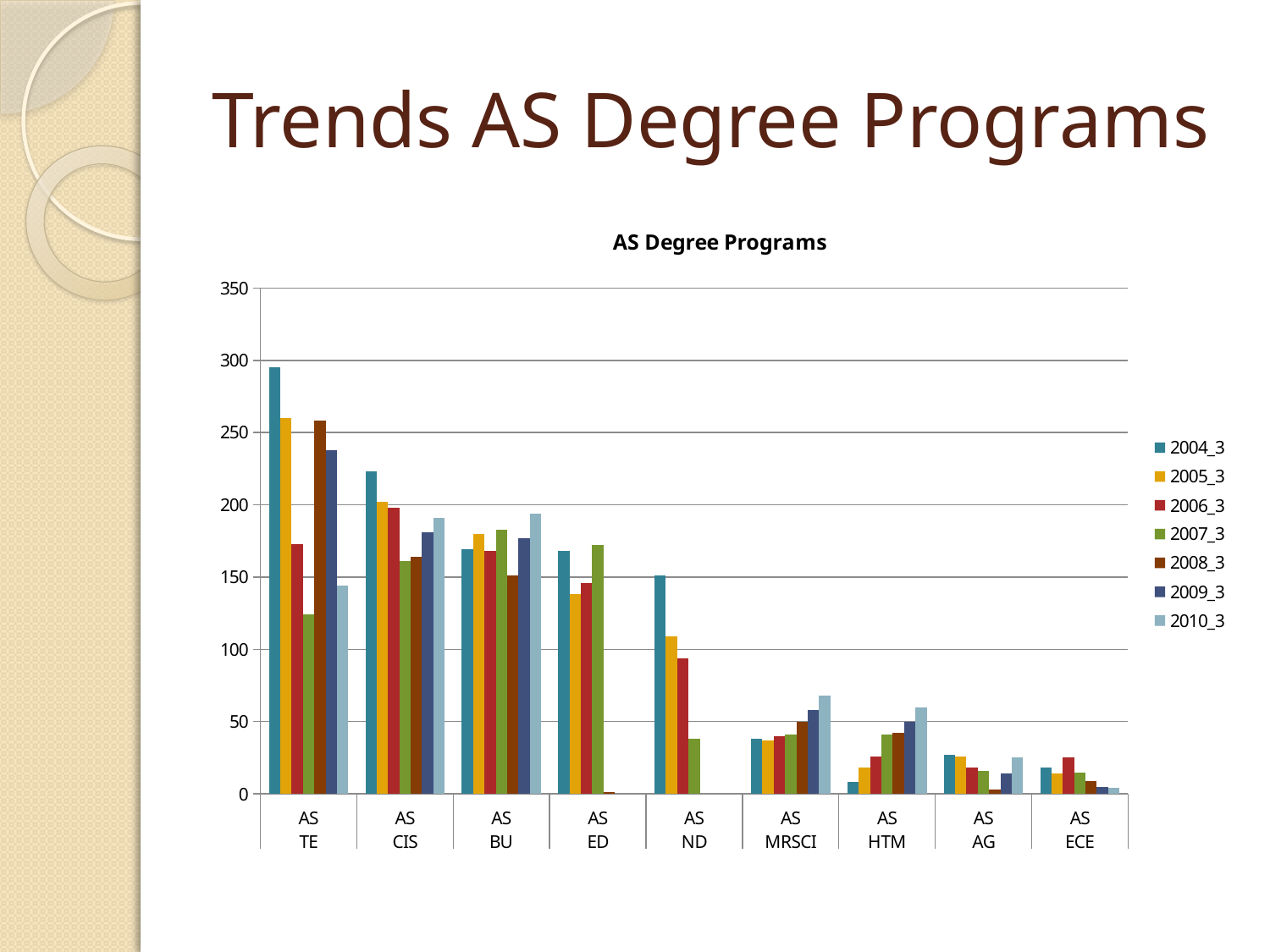
How many degree programs are shown on the x axis? 9 What is the title of the chart? AS Degree Programs Is the 2004_3 value for AS CIS greater or less than 200? greater Is the 2010_3 value for AS MRSCI greater or less than 50? greater Which program has the highest 2004_3 bar? AS TE Which is larger, the 2004_3 value for AS TE or the 2004_3 value for AS CIS? AS TE What kind of chart is shown on the slide? bar chart How many series does the legend list? 7 For AS HTM, do the values rise or fall from 2004_3 to 2010_3? rise Is the 2004_3 value for AS ND greater or less than 100? greater Which series has the highest bar for AS TE? 2004_3